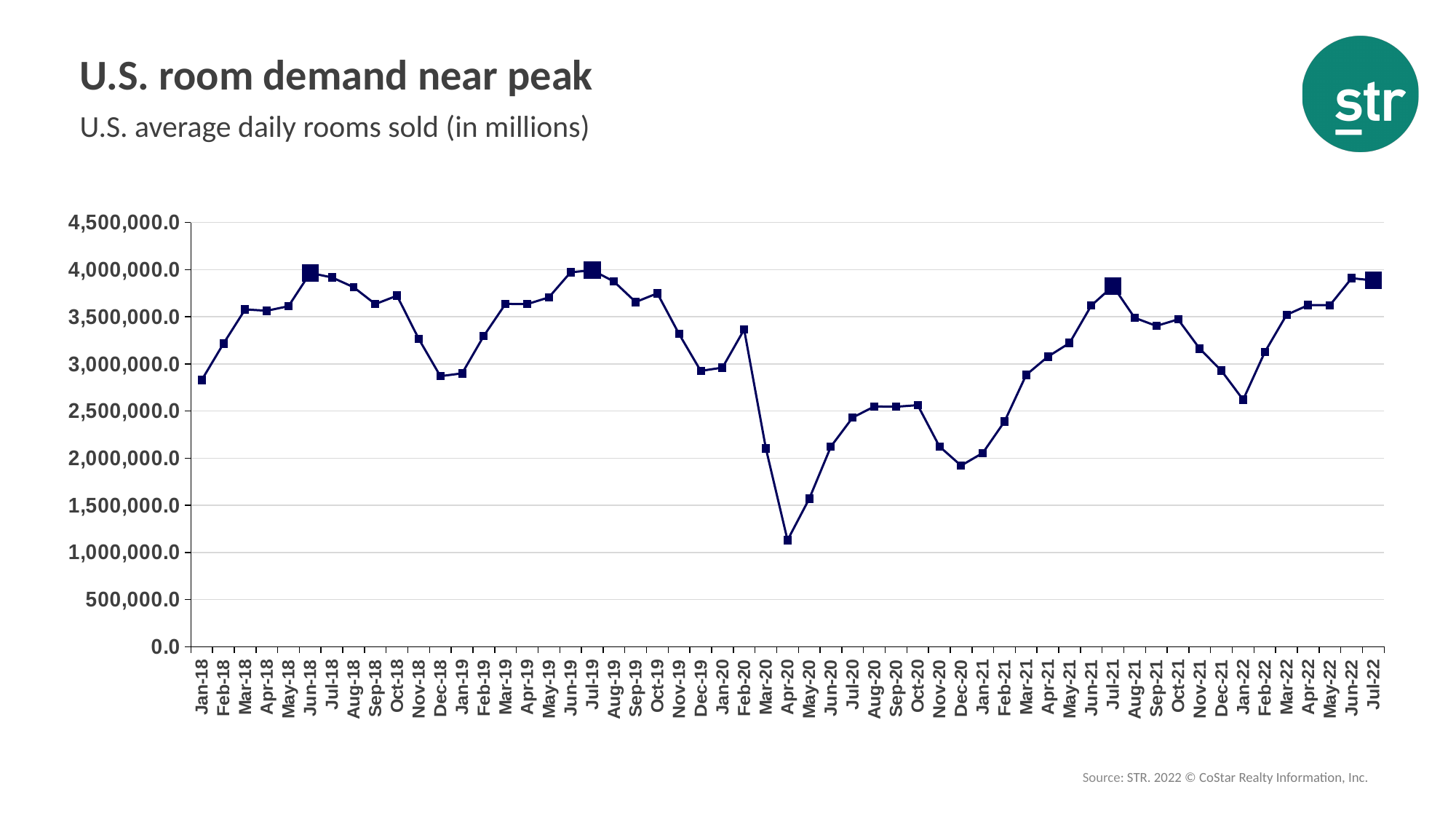
Is the value for Jan-18 greater or less than 3,000,000.0? less Do the values rise or fall from Feb-20 to Apr-20? fall Is the value for Jun-21 greater or less than 3,500,000.0? greater Which month has the lowest value on the chart? Apr-20 Which is larger, the value for Apr-19 or the value for Apr-20? Apr-19 What kind of chart is shown on the slide? line chart Is the value for Jul-22 greater or less than 3,500,000.0? greater How many monthly data points are plotted on the chart? 55 What is the title of the chart on the slide? U.S. room demand near peak Which is larger, the value for Jan-21 or the value for Jan-22? Jan-22